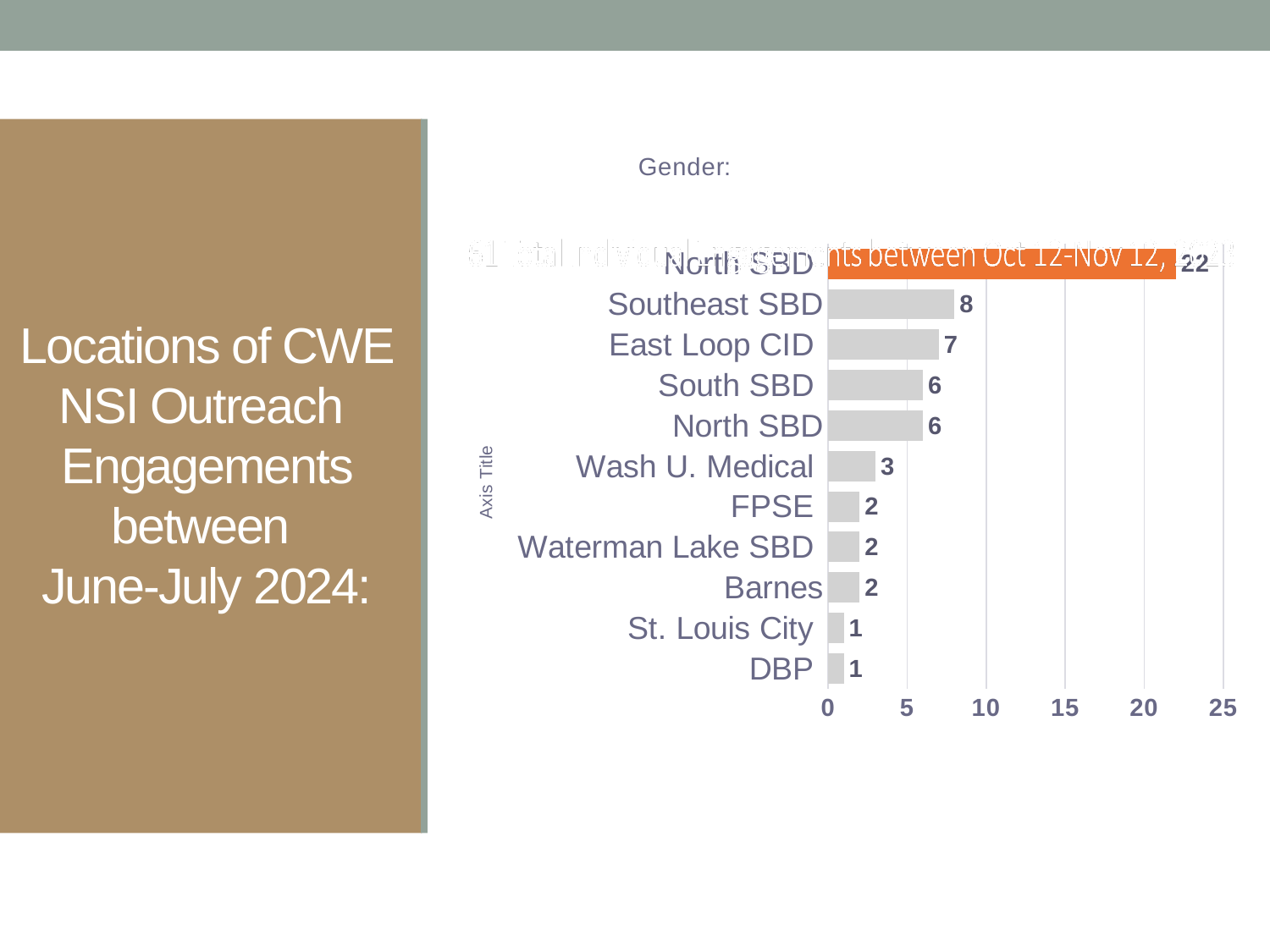
What is the value for Waterman Lake SBD? 2 What is the value for East Loop CID? 7 What colour is the bar with the highest value? Orange What is the difference between the value for Southeast SBD and the value for East Loop CID? 1 What kind of chart is shown on the slide? Bar chart What is the value of the orange bar at the top of the chart? 22 What is the value for Wash U. Medical? 3 What is the value for Southeast SBD? 8 Which is larger, the value for South SBD or the value for Wash U. Medical? South SBD How many categories are shown on the chart? 11 Which category has the highest value? North SBD (top bar) What is the value for DBP? 1